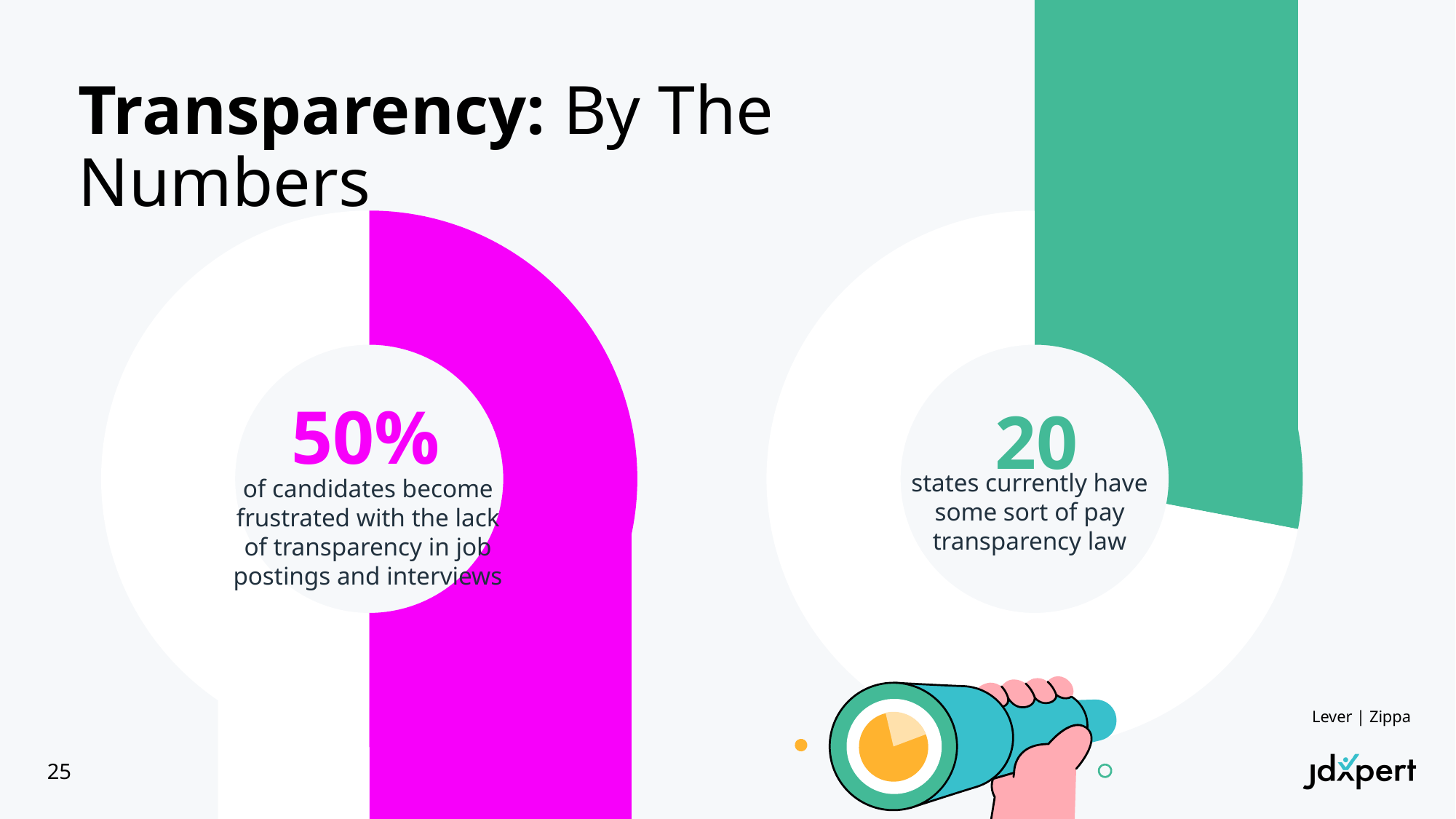
On the left chart, what share of the ring is filled in magenta? 50% How many charts are shown on the slide? 2 On the left chart, what does the 50% figure describe? Candidates who become frustrated with the lack of transparency in job postings and interviews What colour is the filled portion of the left chart? Magenta On the left chart, what percentage of candidates become frustrated with the lack of transparency in job postings and interviews? 50% On the right chart, how many states currently have some sort of pay transparency law? 20 On the right chart, what does the number 20 describe? States that currently have some sort of pay transparency law What kind of chart is used on the right side of the slide? Donut (pie) chart What kind of chart is used on the left side of the slide? Donut (pie) chart What colour is the filled portion of the right chart? Green